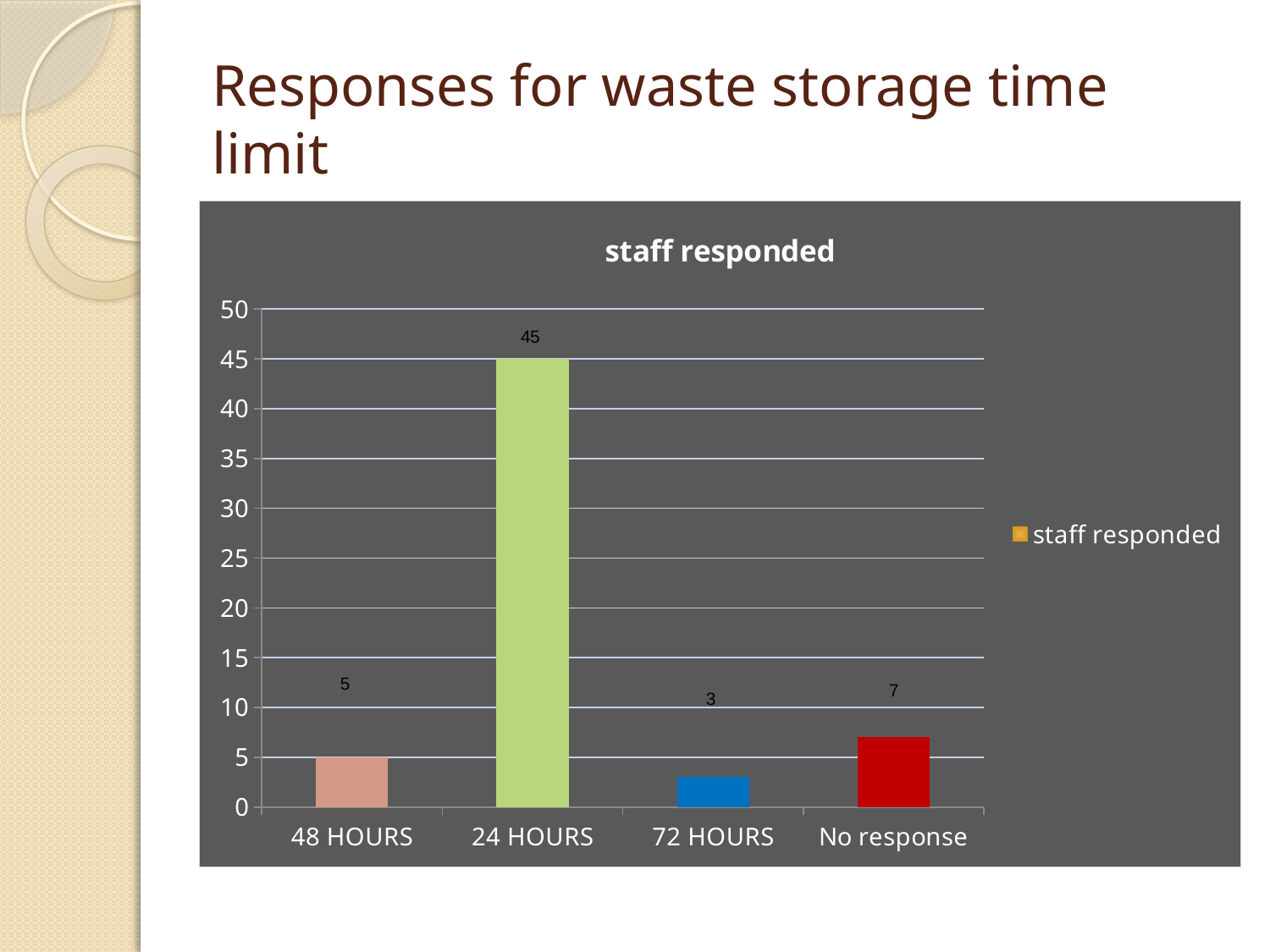
What kind of chart is shown on the slide? bar chart How many series does the legend list? 1 Which category has the lowest number of staff responses? 72 HOURS What is the difference between the values for 24 HOURS and No response? 38 How many categories are shown on the x axis? 4 What is the value for No response? 7 How many staff responded with 24 HOURS? 45 Which is larger, the value for 48 HOURS or the value for No response? No response What is the difference between the values for No response and 72 HOURS? 4 Which category has the highest number of staff responses? 24 HOURS What is the value for 48 HOURS? 5 Is the value for 24 HOURS greater or less than 40? greater